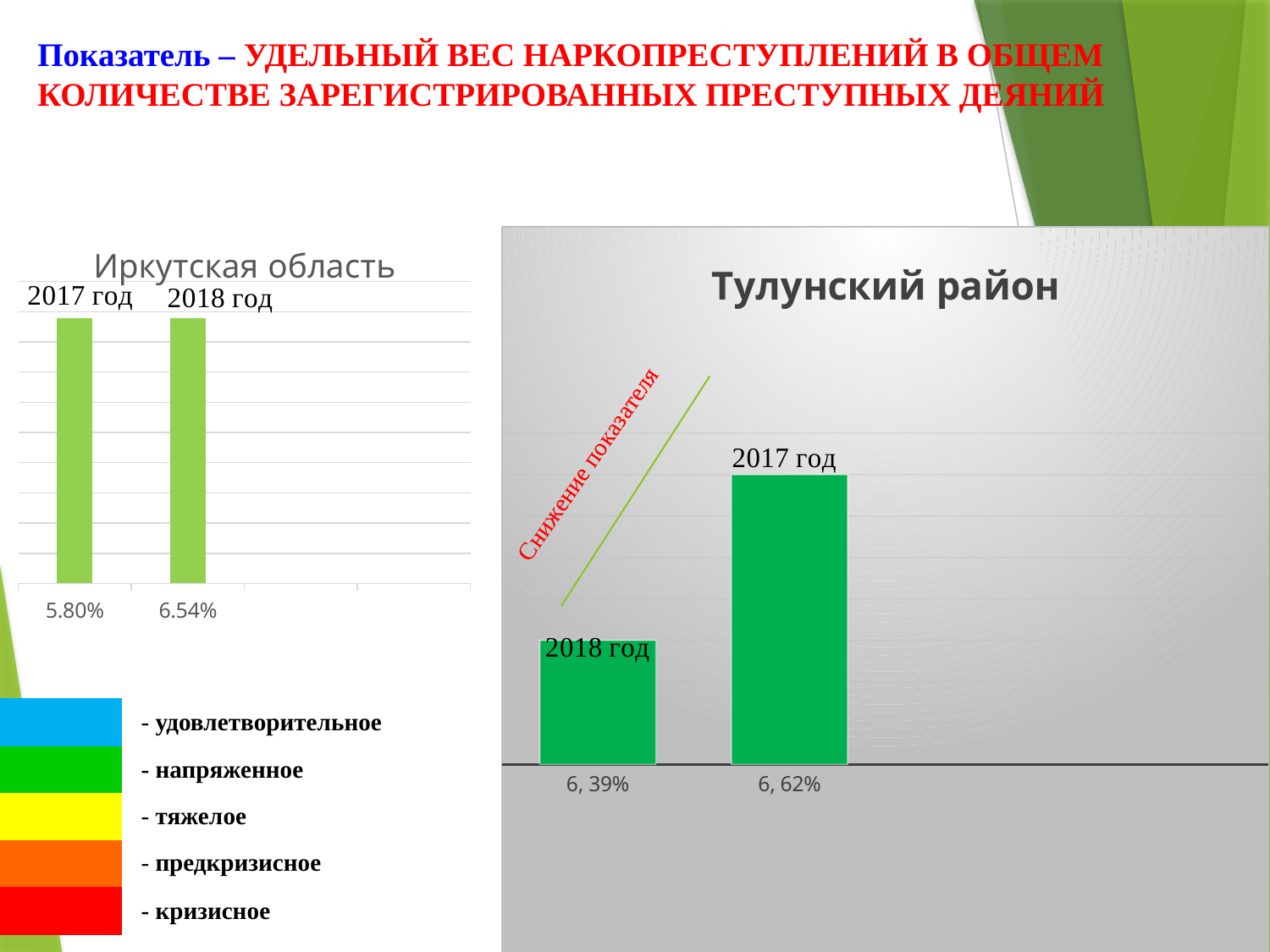
In the chart titled "Иркутская область", what is the value for 2017 год? 5.80% In the chart titled "Иркутская область", what is the difference between the 2018 год and 2017 год values? 0.74% How many bars are shown in the chart titled "Тулунский район"? 2 In the chart titled "Тулунский район", what is the value for 2017 год? 6, 62% In the chart titled "Тулунский район", which year has the higher value? 2017 год In the chart titled "Тулунский район", does the value rise or fall from 2017 год to 2018 год? fall In the chart titled "Тулунский район", which year has the lower value? 2018 год What type of chart is the chart titled "Иркутская область"? bar chart In the chart titled "Тулунский район", what is the value for 2018 год? 6, 39% In the chart titled "Иркутская область", what is the value for 2018 год? 6.54% In the chart titled "Тулунский район", what is the difference between the 2017 год and 2018 год values? 0,23% In the chart titled "Тулунский район", is the value for 2017 год larger or smaller than the value for 2018 год? larger